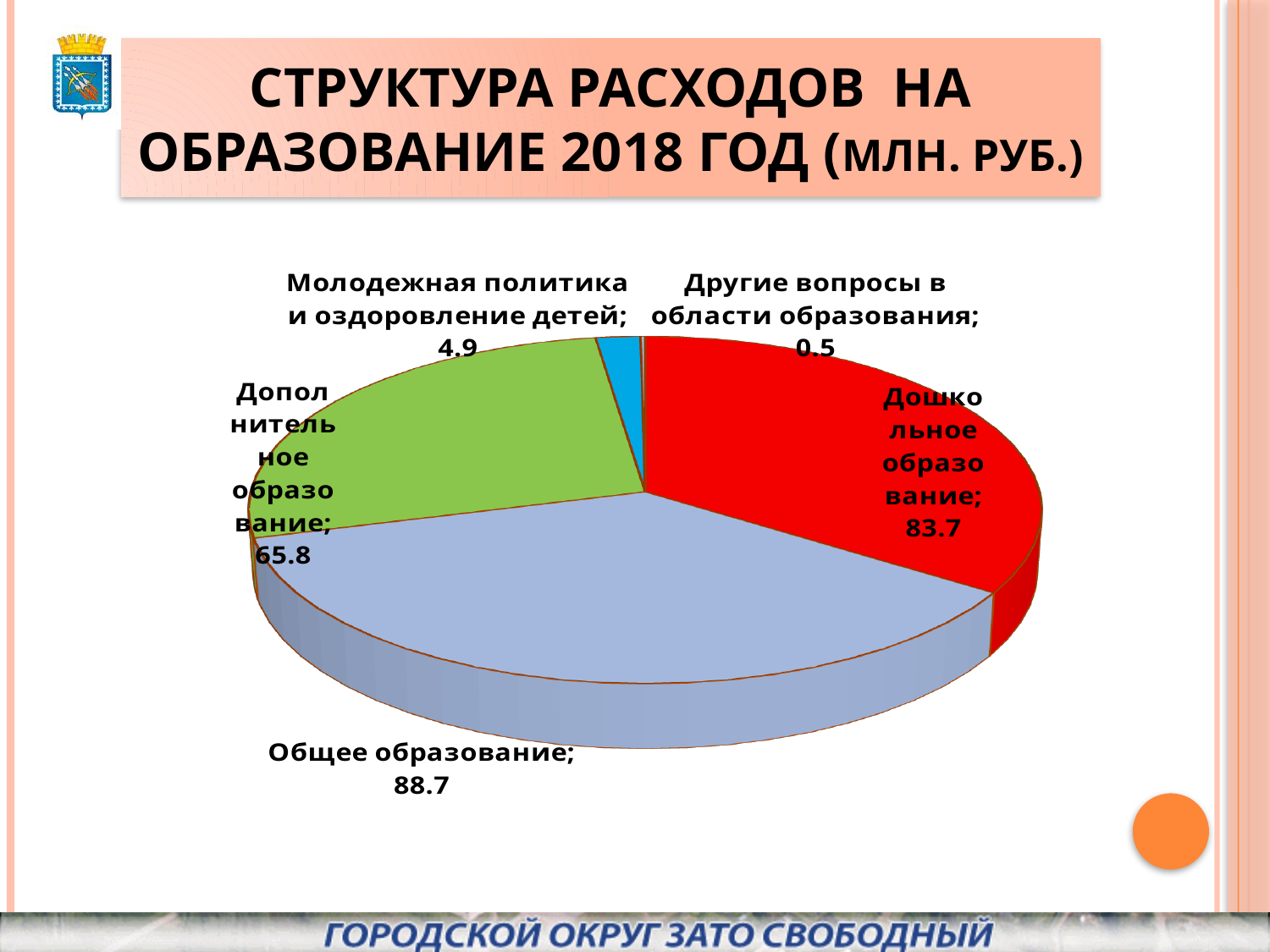
How many categories does the pie chart show? 5 What is the value for Молодежная политика и оздоровление детей? 4.9 What is the total of all slices in the pie chart? 243.6 What type of chart is shown on the slide? Pie chart Which category has the largest value? Общее образование What is the value for Общее образование? 88.7 What is the difference between Дошкольное образование and Дополнительное образование? 17.9 What is the value for Дошкольное образование? 83.7 What is the value for Дополнительное образование? 65.8 Which is larger, Дополнительное образование or Молодежная политика и оздоровление детей? Дополнительное образование Which category has the smallest value? Другие вопросы в области образования What is the difference between Общее образование and Дошкольное образование? 5.0